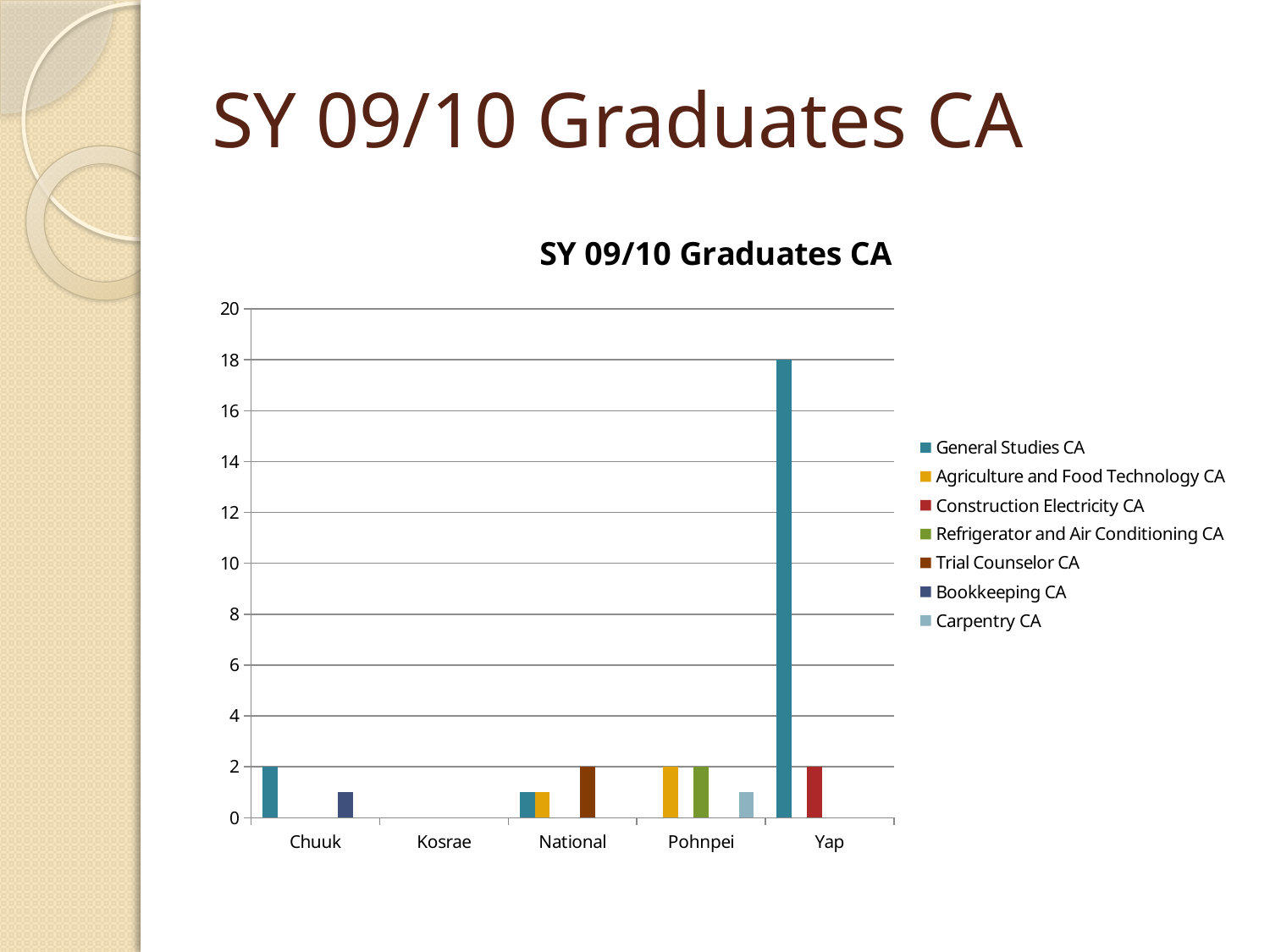
How many categories are shown on the x axis? 5 What is the value for General Studies CA in Chuuk? 2 Which is larger: General Studies CA in Chuuk or General Studies CA in National? General Studies CA in Chuuk Which category has the tallest bar in the chart? Yap How many series does the legend list? 7 What is the difference between General Studies CA in Yap and Construction Electricity CA in Yap? 16 What is the value for Trial Counselor CA in National? 2 What type of chart is shown on the slide? bar chart Is the value for General Studies CA in Yap greater or less than 16? greater What is the value for General Studies CA in Yap? 18 What is the title of the chart? SY 09/10 Graduates CA